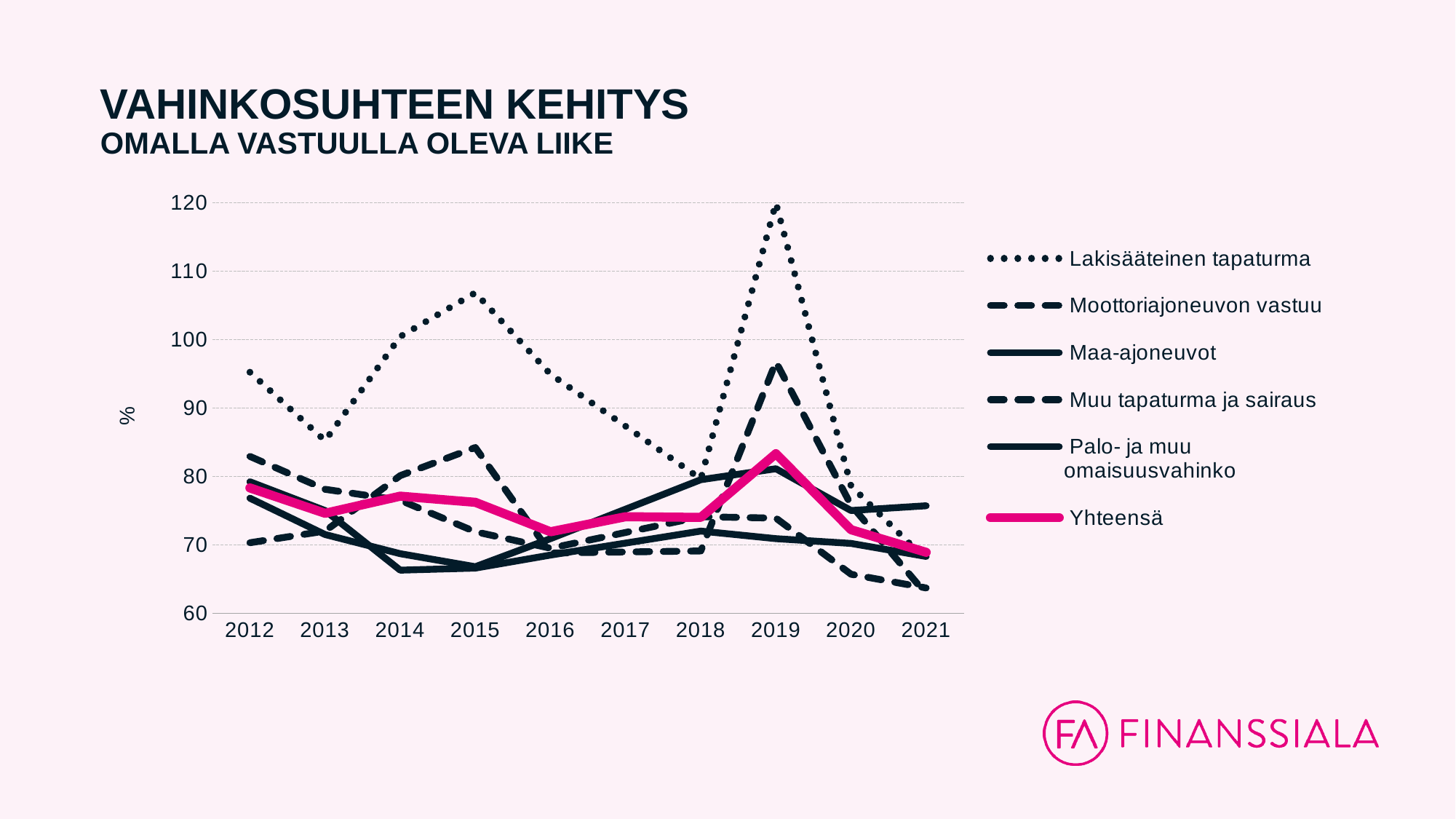
Is the value for Lakisääteinen tapaturma in 2019 greater or less than 110? greater In 2019, which is higher: Lakisääteinen tapaturma or Yhteensä? Lakisääteinen tapaturma In which year does the Lakisääteinen tapaturma series reach its highest value? 2019 Is the value for Lakisääteinen tapaturma in 2013 greater or less than 90? less Does the Lakisääteinen tapaturma series rise or fall from 2019 to 2021? fall Is the value for Lakisääteinen tapaturma in 2015 greater or less than 100? greater What kind of chart is shown on the slide? line chart How many years are shown on the x axis? 10 Which series is drawn in pink? Yhteensä In which year does the Yhteensä series reach its highest value? 2019 How many series does the legend list? 6